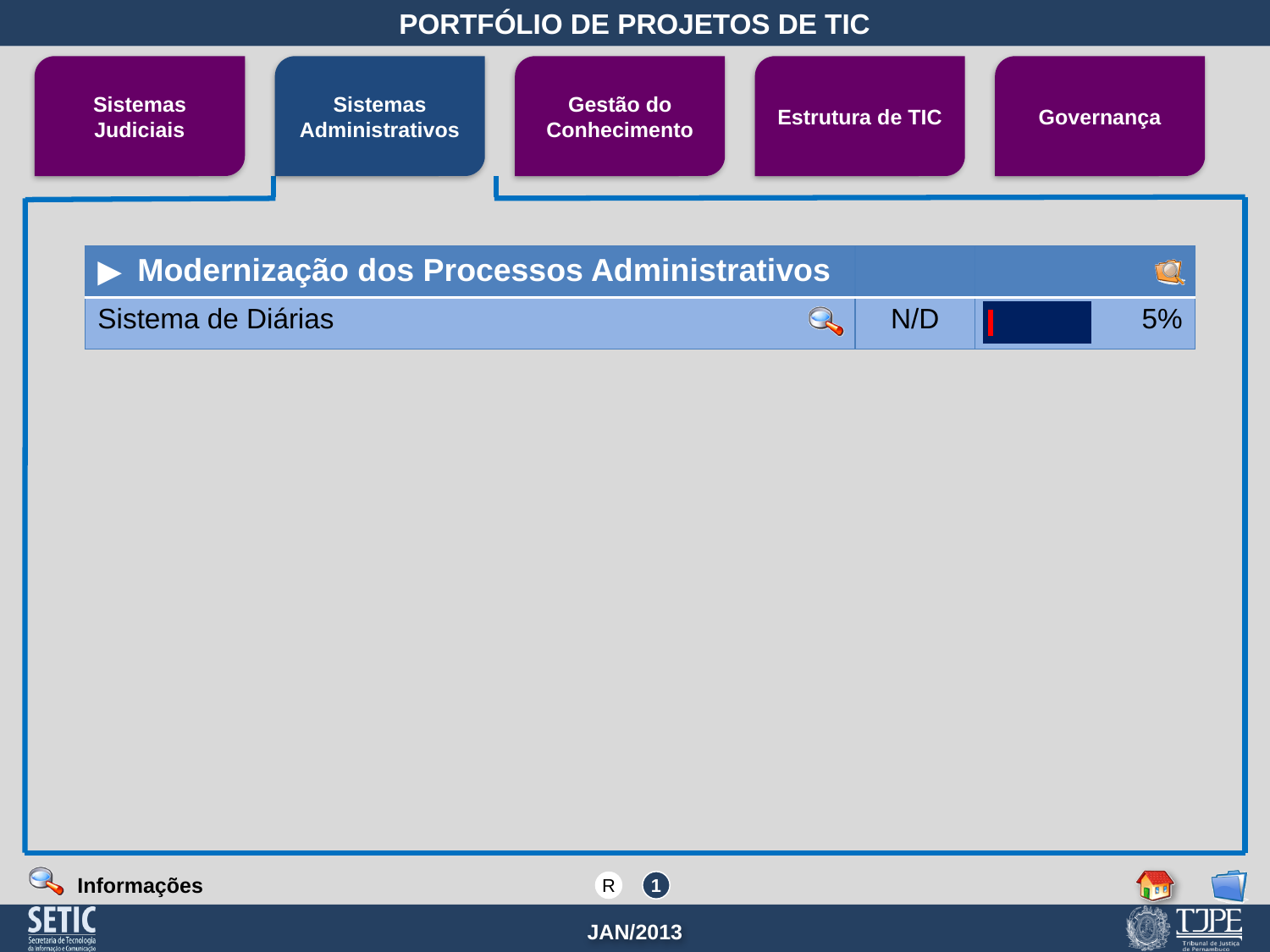
Is the progress value for Sistema de Diárias greater or less than 50%? less What kind of chart is used to show the progress of Sistema de Diárias? bar chart What percentage is shown for Sistema de Diárias in the progress bar? 5% What value is shown in the column to the left of the progress bar for Sistema de Diárias? N/D What is the heading of the group that contains the Sistema de Diárias progress bar? Modernização dos Processos Administrativos How many projects are listed with a progress bar under Modernização dos Processos Administrativos? 1